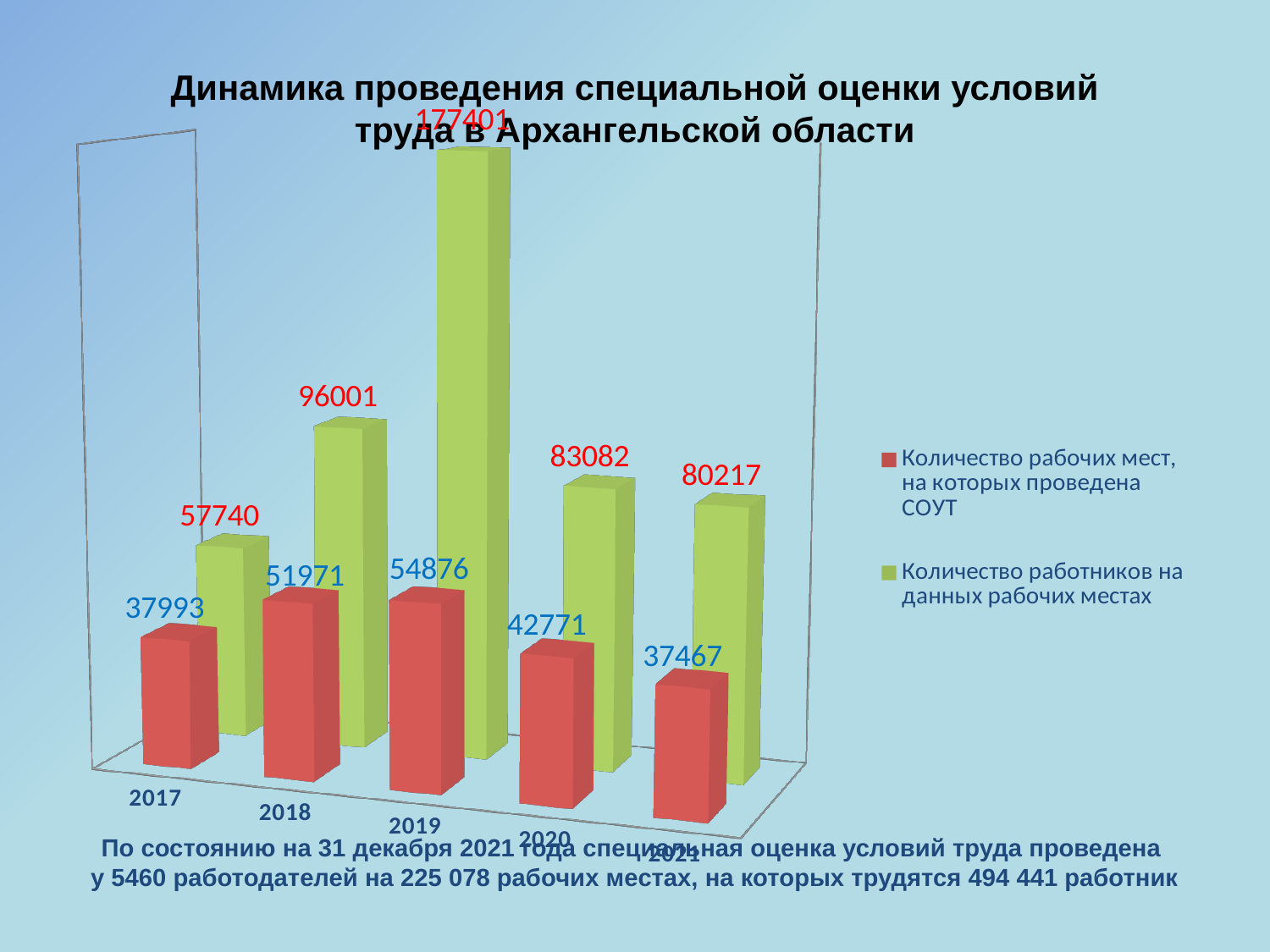
What is the value of 'Количество работников на данных рабочих местах' for 2021? 80217 How many years are shown on the x axis of the chart? 5 What is the value of 'Количество рабочих мест, на которых проведена СОУТ' for 2020? 42771 What is the value of 'Количество работников на данных рабочих местах' for 2019? 177401 In which year is 'Количество рабочих мест, на которых проведена СОУТ' highest? 2019 How many series does the legend list? 2 In which year is 'Количество работников на данных рабочих местах' lowest? 2017 Which is larger: 'Количество работников на данных рабочих местах' in 2018 or in 2020? 2018 What kind of chart is shown on the slide? bar chart What is the difference between 'Количество работников на данных рабочих местах' and 'Количество рабочих мест, на которых проведена СОУТ' in 2017? 19747 What is the value of 'Количество рабочих мест, на которых проведена СОУТ' for 2018? 51971 Which colour represents 'Количество работников на данных рабочих местах' in the chart? green